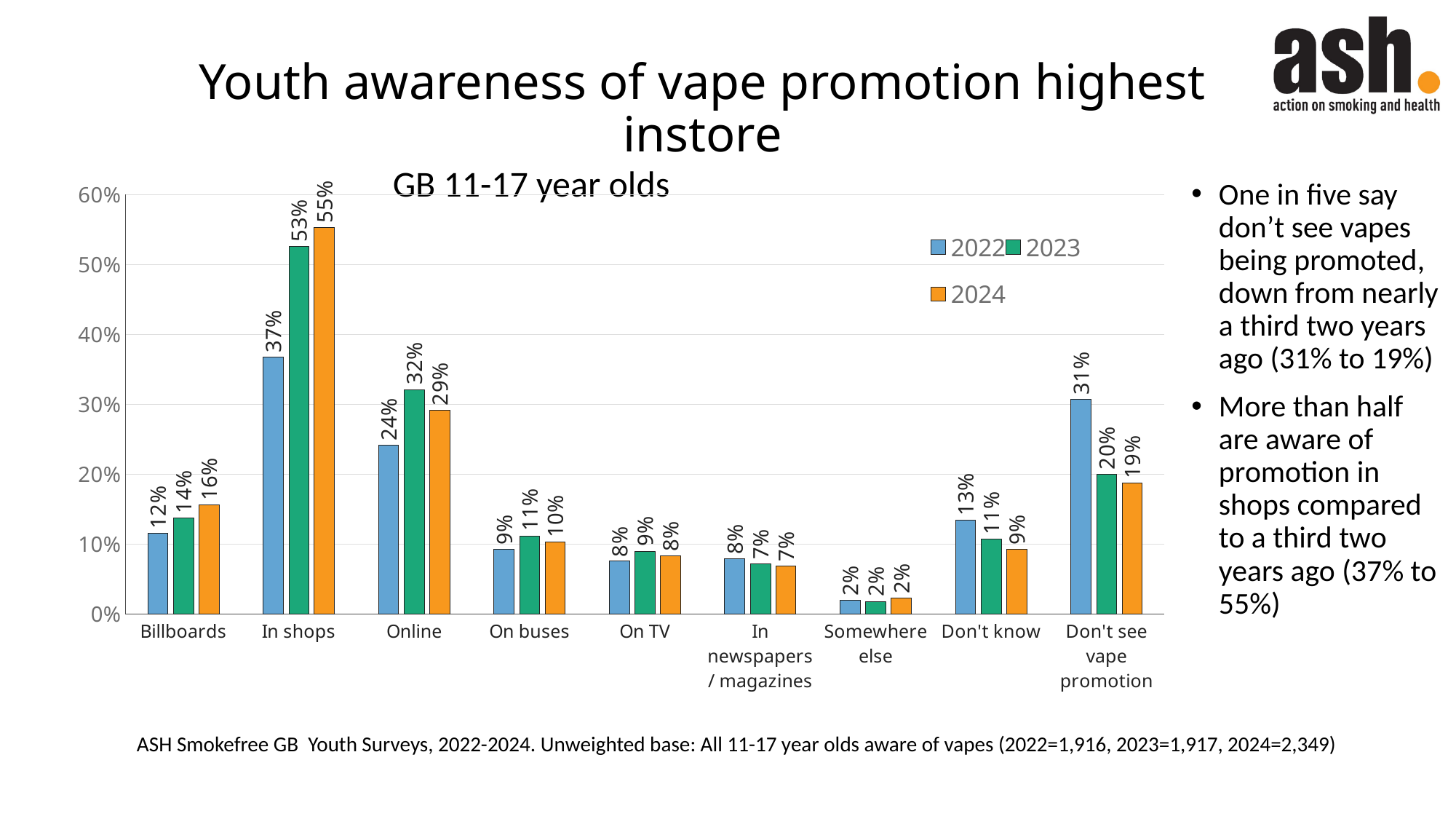
What is the subtitle shown above the chart? GB 11-17 year olds Do the values for Don't see vape promotion rise or fall from 2022 to 2024? Fall Which category has the highest value in the 2024 series? In shops Which category has the lowest value in the 2022 series? Somewhere else Which is larger: the 2022 value for Billboards or the 2022 value for Don't know? Don't know How many categories are shown on the x axis? 9 What is the difference between the 2024 and 2022 values for In shops? 18% What kind of chart is shown on the slide? Bar chart What is the 2024 value for In shops? 55% What is the 2023 value for Online? 32% What is the 2022 value for Don't see vape promotion? 31% How many series does the legend list? 3